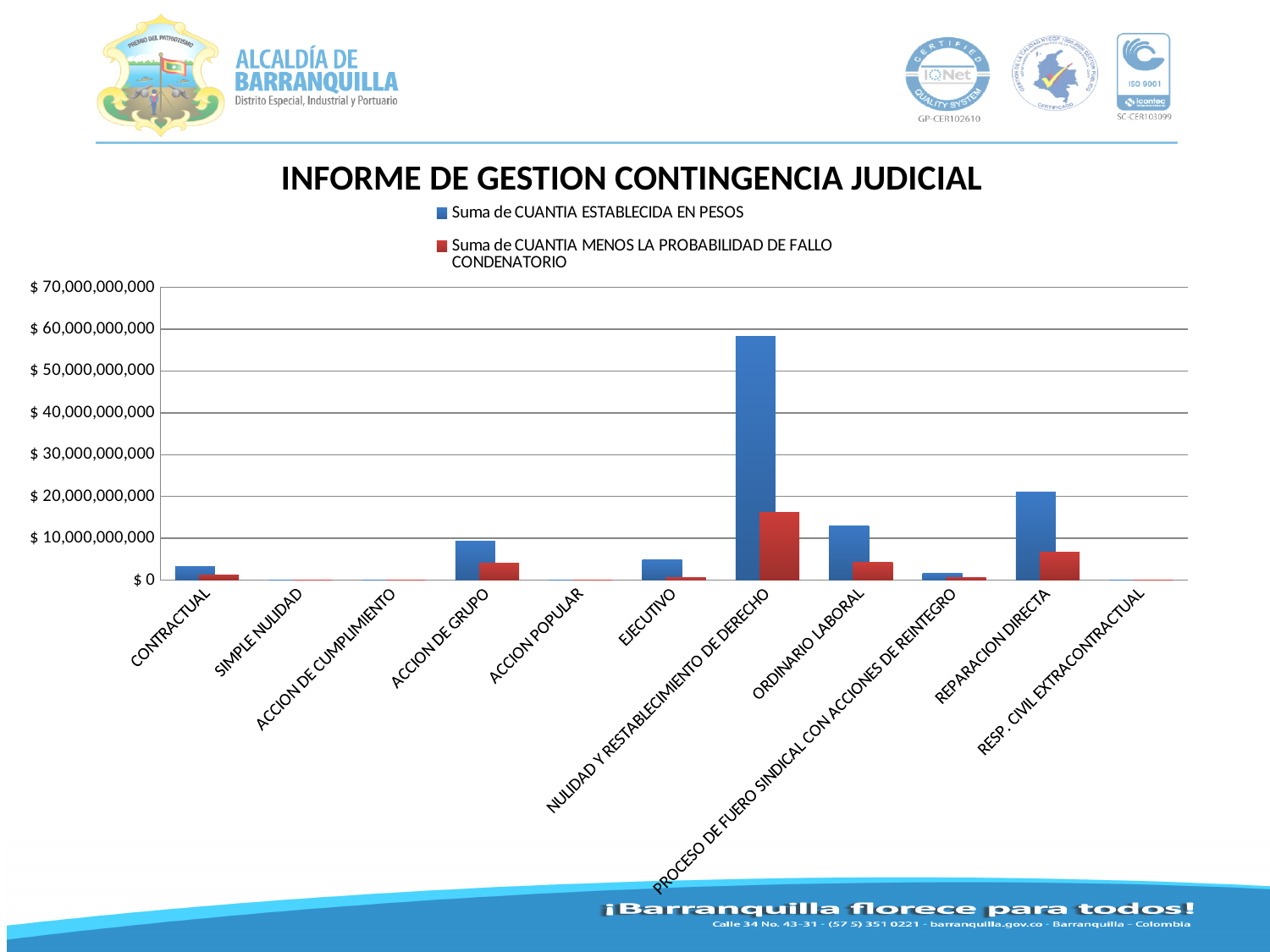
Is the Suma de CUANTIA ESTABLECIDA EN PESOS value for REPARACION DIRECTA greater or less than $ 10,000,000,000? greater Is the Suma de CUANTIA MENOS LA PROBABILIDAD DE FALLO CONDENATORIO value for NULIDAD Y RESTABLECIMIENTO DE DERECHO greater or less than $ 20,000,000,000? less What is the title of the chart? INFORME DE GESTION CONTINGENCIA JUDICIAL Which category has the highest value for Suma de CUANTIA ESTABLECIDA EN PESOS? NULIDAD Y RESTABLECIMIENTO DE DERECHO Which has a larger Suma de CUANTIA ESTABLECIDA EN PESOS value, REPARACION DIRECTA or ORDINARIO LABORAL? REPARACION DIRECTA How many series does the legend list? 2 Which has a larger Suma de CUANTIA ESTABLECIDA EN PESOS value, NULIDAD Y RESTABLECIMIENTO DE DERECHO or REPARACION DIRECTA? NULIDAD Y RESTABLECIMIENTO DE DERECHO Is the Suma de CUANTIA ESTABLECIDA EN PESOS value for EJECUTIVO greater or less than $ 10,000,000,000? less How many categories are shown on the x axis? 11 Which colour represents Suma de CUANTIA MENOS LA PROBABILIDAD DE FALLO CONDENATORIO in the legend? red What kind of chart is shown on the slide? bar chart